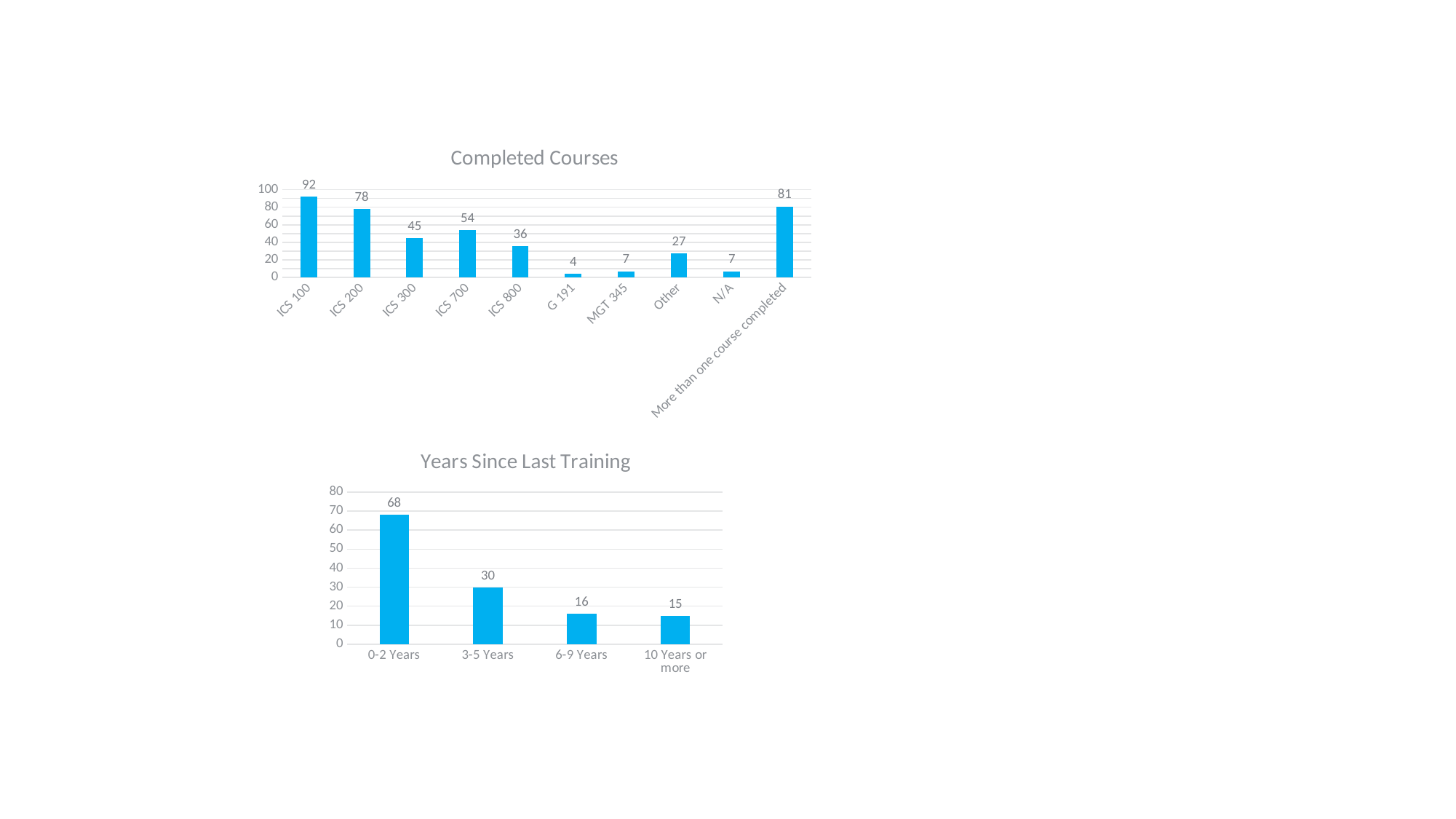
In the 'Completed Courses' chart, what is the difference between ICS 200 and ICS 300? 33 What kind of chart is 'Years Since Last Training'? Bar chart In the 'Completed Courses' chart, which is larger, the value for Other or the value for ICS 800? ICS 800 In the 'Years Since Last Training' chart, do the values rise or fall from left to right along the x axis? Fall In the 'Years Since Last Training' chart, what is the difference between 0-2 Years and 10 Years or more? 53 In the 'Completed Courses' chart, which category has the highest value? ICS 100 In the 'Completed Courses' chart, what is the value for ICS 100? 92 In the 'Years Since Last Training' chart, which category has the highest value? 0-2 Years In the 'Completed Courses' chart, what is the value for ICS 700? 54 In the 'Completed Courses' chart, how many categories are shown on the x axis? 10 In the 'Years Since Last Training' chart, what is the value for 3-5 Years? 30 In the 'Completed Courses' chart, which category has the lowest value? G 191